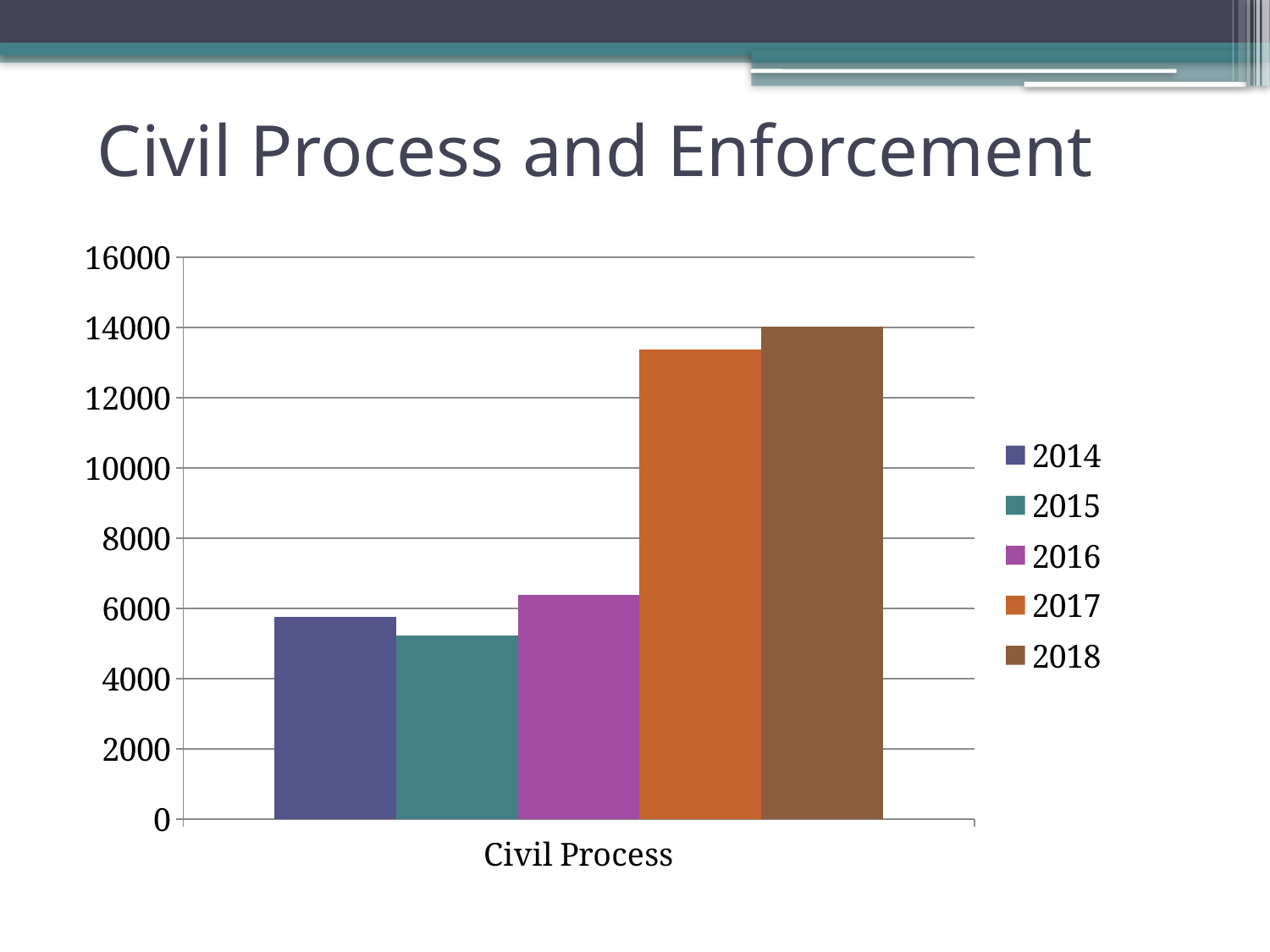
How many series does the legend list? 5 Is the value for 2015 greater or less than 4000? greater What kind of chart is shown on the slide? bar chart Is the value for 2017 greater or less than 12000? greater What is the title of the slide? Civil Process and Enforcement What is the category label shown on the x axis? Civil Process Which is larger, the value for 2017 or the value for 2016? 2017 Is the value for 2016 greater or less than 6000? greater Which year has the lowest value for Civil Process? 2015 Which is larger, the value for 2016 or the value for 2014? 2016 Which year has the highest value for Civil Process? 2018